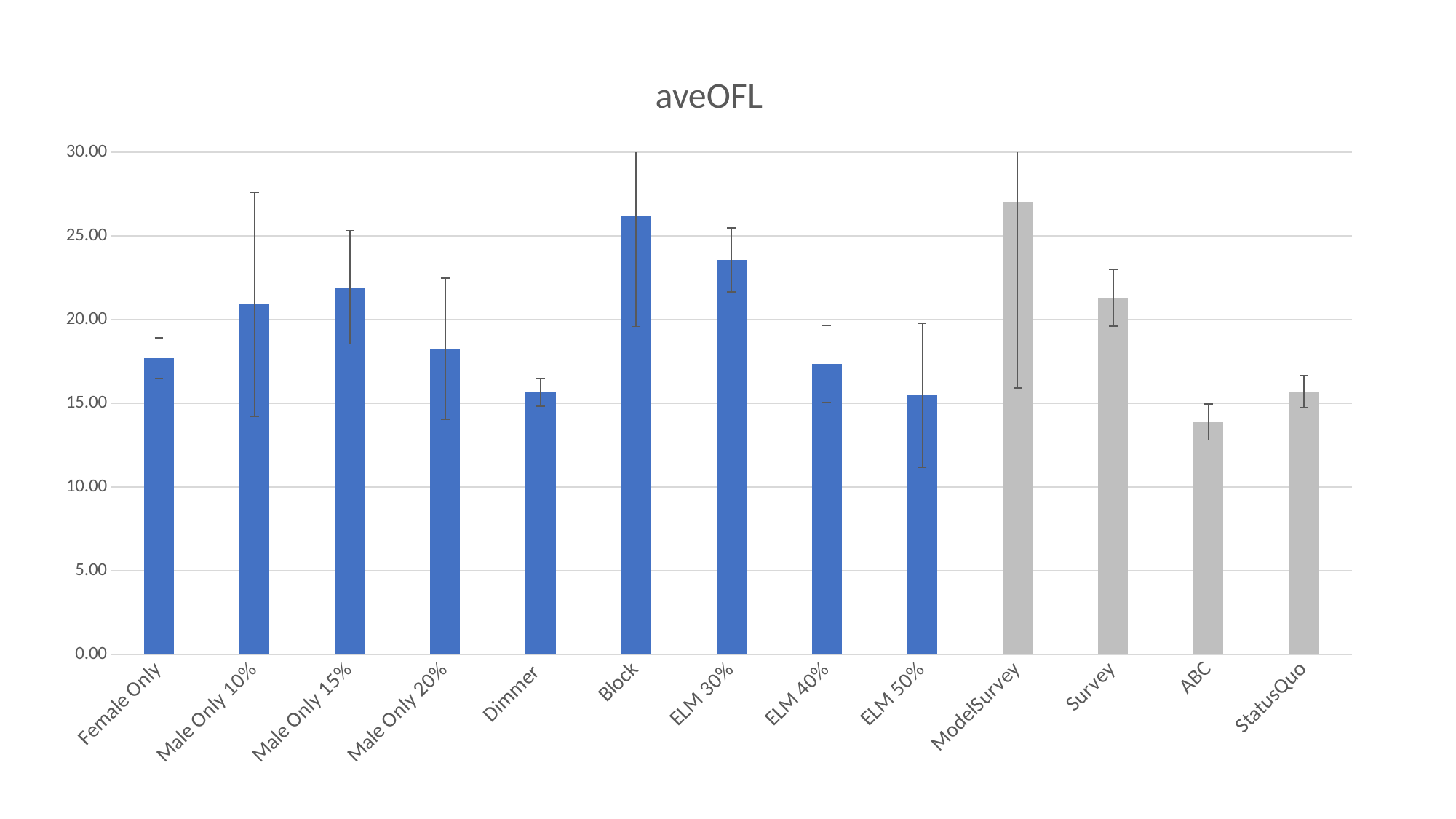
Which category has the lowest value? ABC Which category has the highest value? ModelSurvey Is the value for Block greater or less than 25.00? greater How many bars are coloured grey rather than blue? 4 What kind of chart is shown on the slide? bar chart Is the value for Female Only greater or less than 20.00? less Is the value for ELM 30% greater or less than 20.00? greater Which is larger, the value for ELM 30% or the value for Survey? ELM 30% Which is larger, the value for Block or the value for ELM 30%? Block What is the title of the chart? aveOFL How many categories are plotted on the x axis? 13